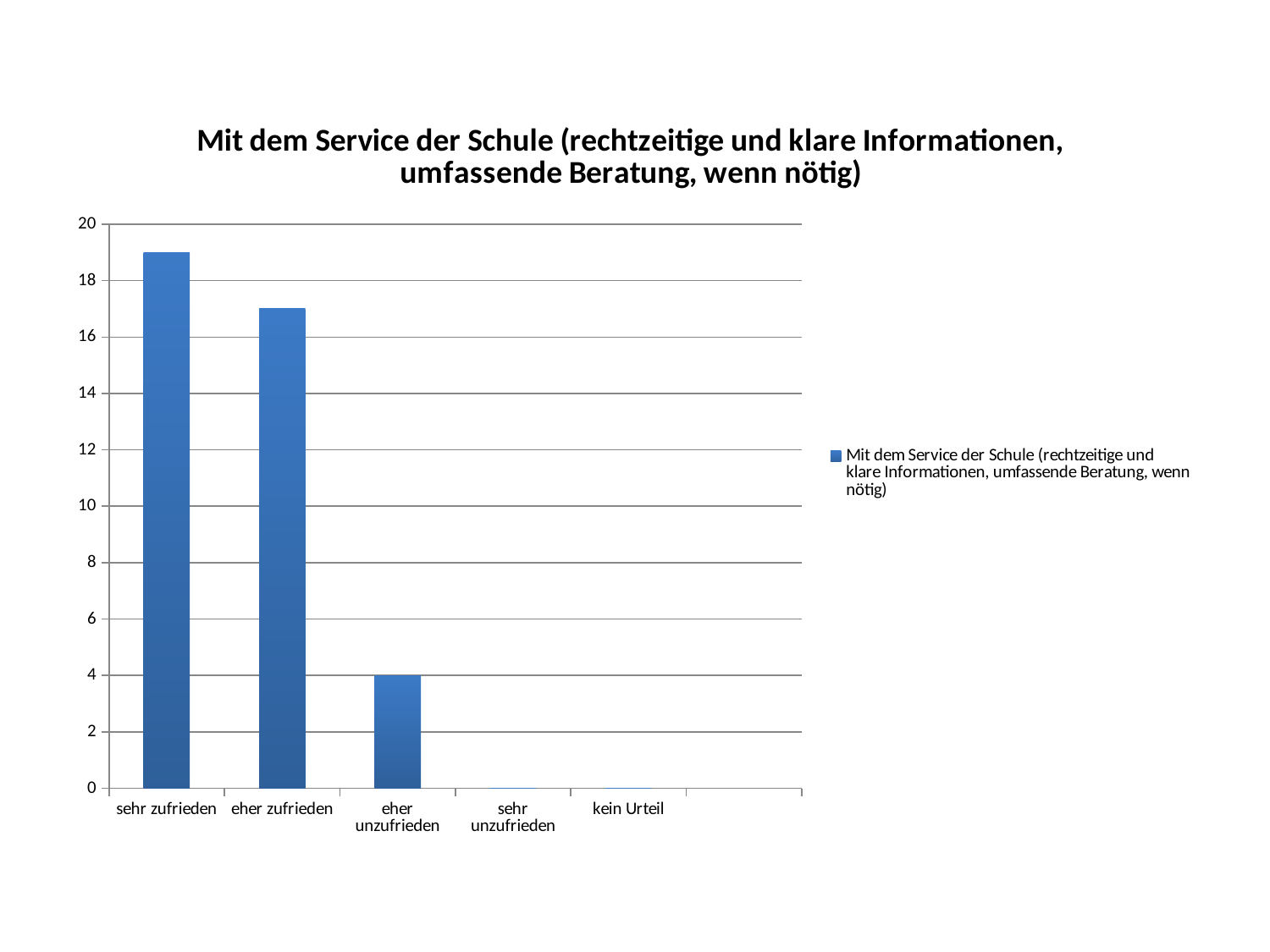
What is the value for eher unzufrieden? 4 Is the value for eher zufrieden greater or less than 18? less Is the value for eher zufrieden greater or less than 16? greater Which is larger, the value for eher zufrieden or the value for eher unzufrieden? eher zufrieden Do the values rise or fall from sehr zufrieden to eher unzufrieden along the x axis? fall Which is larger, the value for sehr zufrieden or the value for eher zufrieden? sehr zufrieden How many bars are drawn in the chart? 3 What kind of chart is shown on the slide? bar chart How many series does the legend list? 1 Which category has the highest value? sehr zufrieden What is the highest value shown on the vertical axis? 20 Is the value for sehr zufrieden greater or less than 18? greater